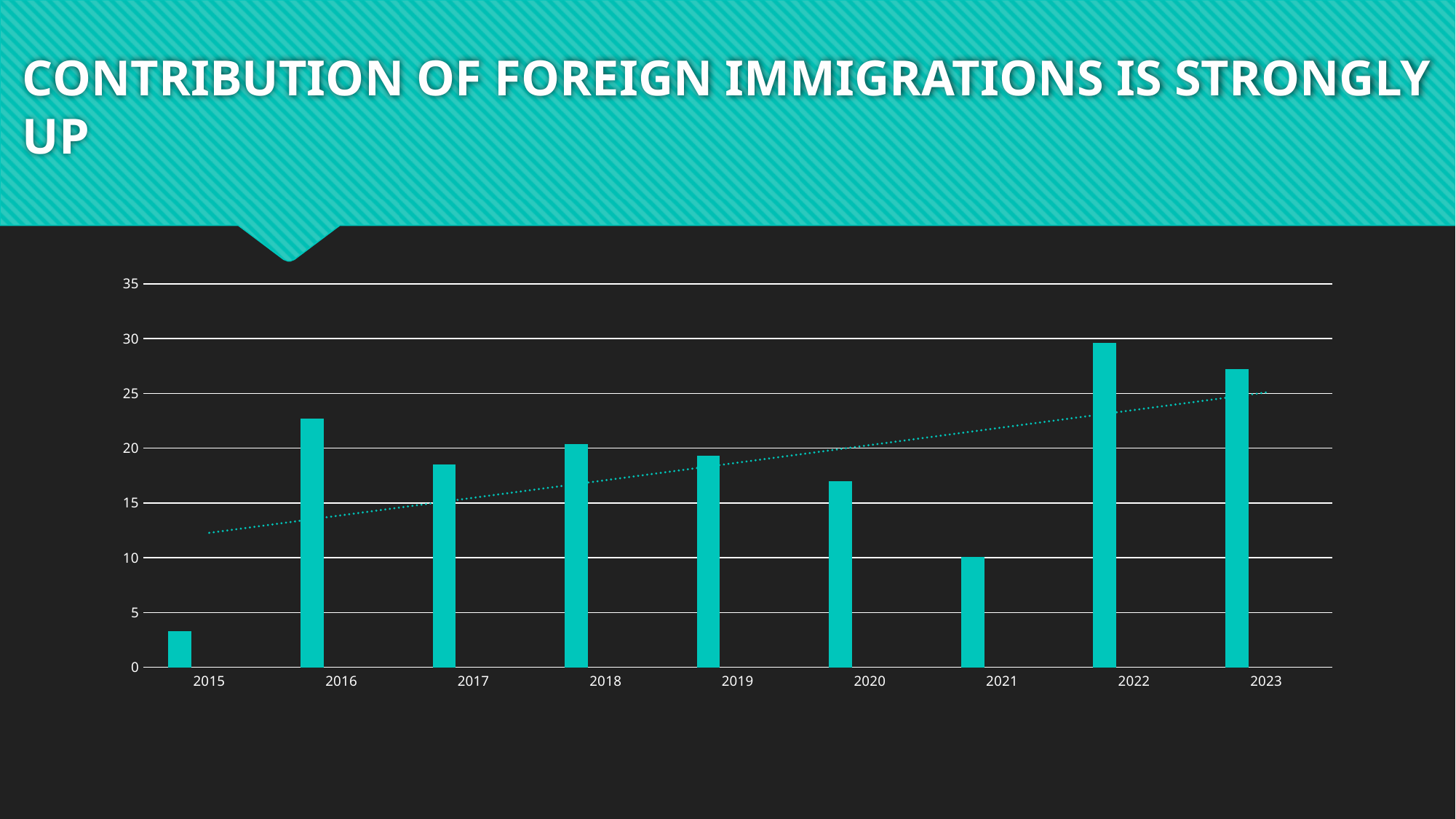
Is the value for 2017 greater or less than 20? less Which year has the larger value, 2016 or 2017? 2016 Which year has the larger value, 2022 or 2023? 2022 Does the dotted trend line in the chart rise or fall from 2015 to 2023? rise Is the value for 2016 greater or less than 20? greater Is the value for 2020 greater or less than 15? greater How many years are shown on the x axis of the chart? 9 What kind of chart is shown on the slide? bar chart Which year has the highest bar in the chart? 2022 Which year has the lowest bar in the chart? 2015